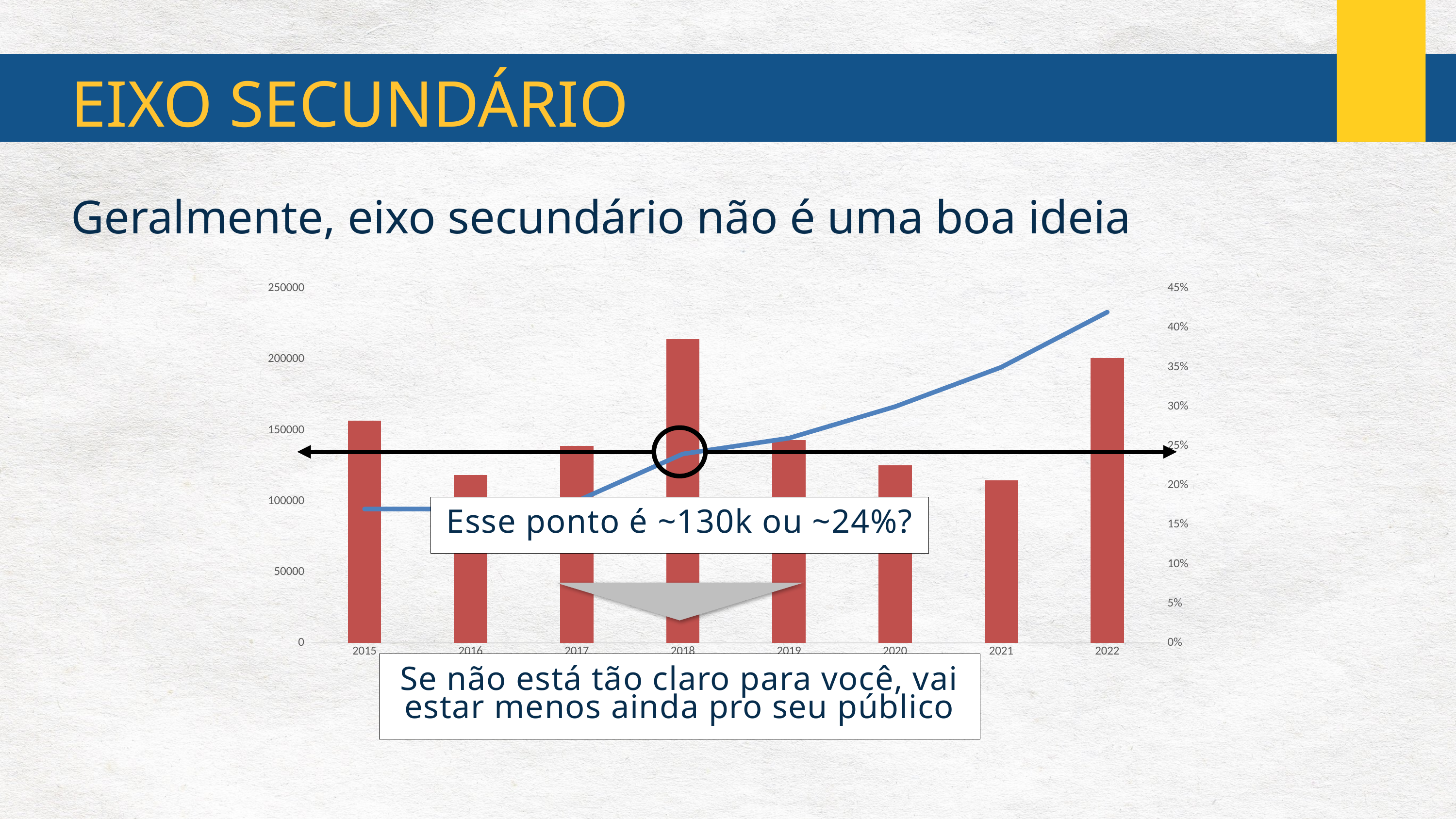
Is the bar for 2022 greater or less than 150000? greater Which year has the tallest bar in the chart? 2018 Does the blue line rise or fall from 2015 to 2022? rises Is the bar for 2016 greater or less than 150000? less Which bar is taller, 2018 or 2022? 2018 How many years are shown along the x axis of the chart? 8 Is the bar for 2021 greater or less than 150000? less What is the highest tick label on the secondary (right) axis of the chart? 45% What kind of chart is shown on the slide? A bar chart combined with a line